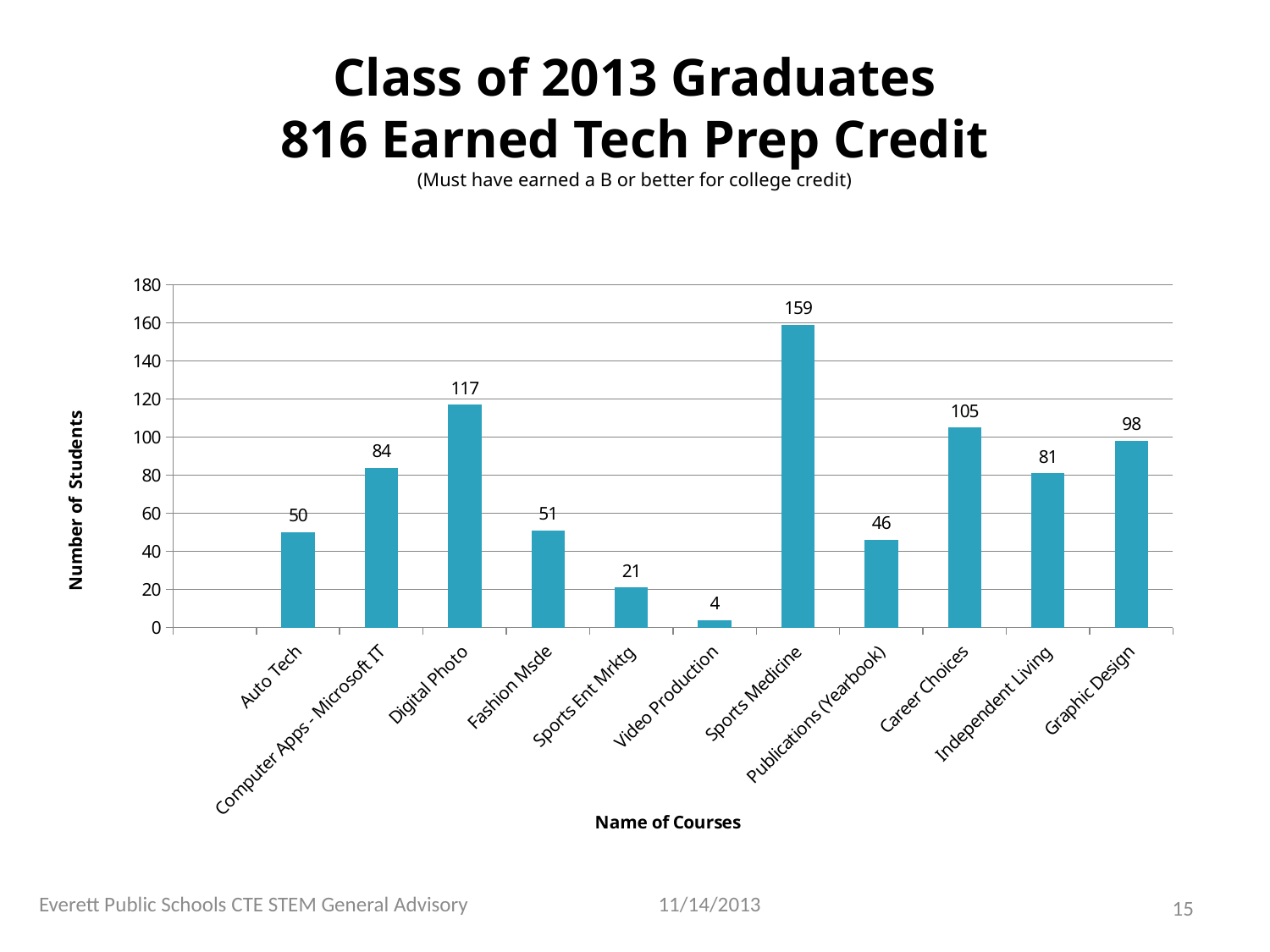
What is the label of the y axis? Number of Students How many courses are shown on the x axis? 11 How many students are shown for Video Production? 4 What is the value shown for Digital Photo? 117 What is the difference between the values for Career Choices and Independent Living? 24 What is the label of the x axis? Name of Courses What kind of chart is shown on the slide? bar chart Is the value for Publications (Yearbook) greater or less than 60? less How many students earned Tech Prep credit in Sports Medicine? 159 Which course has the lowest number of students? Video Production Which has more students, Computer Apps - Microsoft IT or Graphic Design? Graphic Design Which course has the highest number of students? Sports Medicine